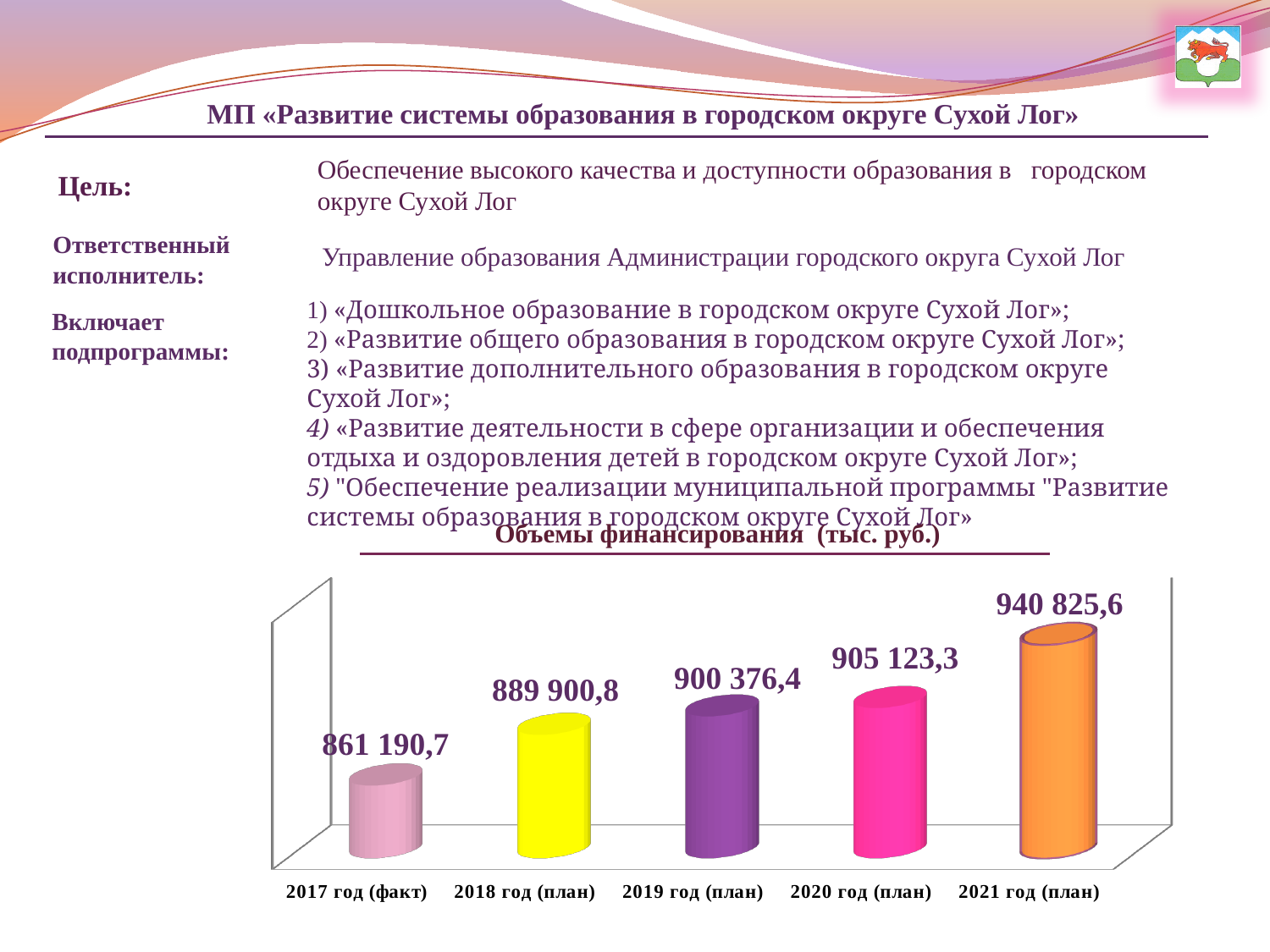
What is the value for 2021 год (план)? 940 825,6 Which is larger, the value for 2018 год (план) or the value for 2019 год (план)? 2019 год (план) What is the difference between the values for 2021 год (план) and 2017 год (факт)? 79 634,9 What is the value for 2017 год (факт)? 861 190,7 What is the value for 2020 год (план)? 905 123,3 Which category has the highest value? 2021 год (план) What is the value for 2019 год (план)? 900 376,4 How many categories are shown in the chart? 5 Which category has the lowest value? 2017 год (факт) What kind of chart is this? bar chart Do the values rise or fall from 2017 год (факт) to 2021 год (план)? rise What is the difference between the values for 2018 год (план) and 2017 год (факт)? 28 710,1